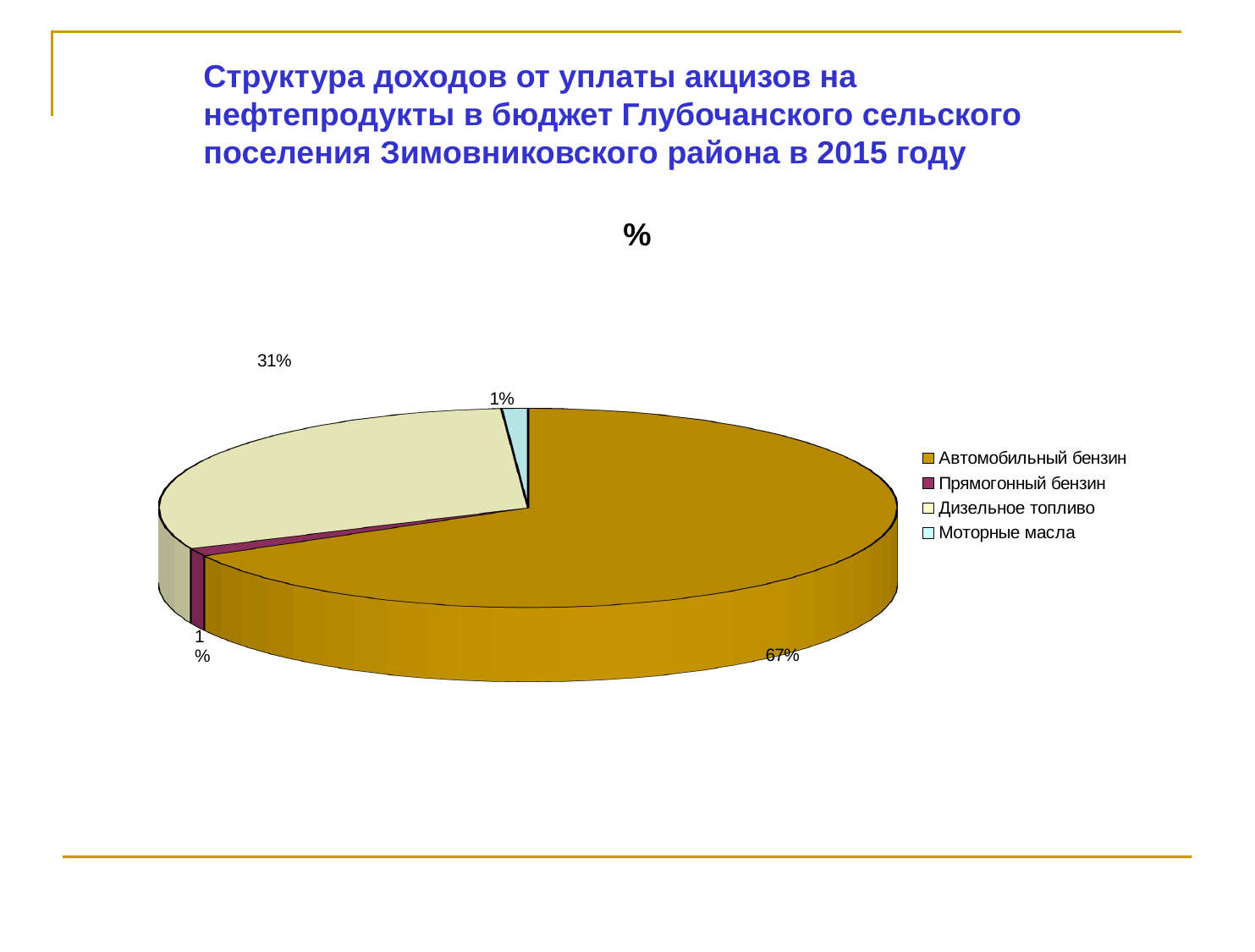
Which has a larger share, Дизельное топливо or Моторные масла? Дизельное топливо What kind of chart is shown on the slide? pie chart What share of the pie does Моторные масла have? 1% Which legend entry is shown in dark purple? Прямогонный бензин What is the difference between the shares of Автомобильный бензин and Дизельное топливо? 36% What share of the pie does Дизельное топливо have? 31% Which category has the largest share of the pie? Автомобильный бензин Which has a larger share, Автомобильный бензин or Дизельное топливо? Автомобильный бензин How many categories does the legend list? 4 What share of the pie does Прямогонный бензин have? 1% What share of the pie does Автомобильный бензин have? 67% What is the title of the chart? %